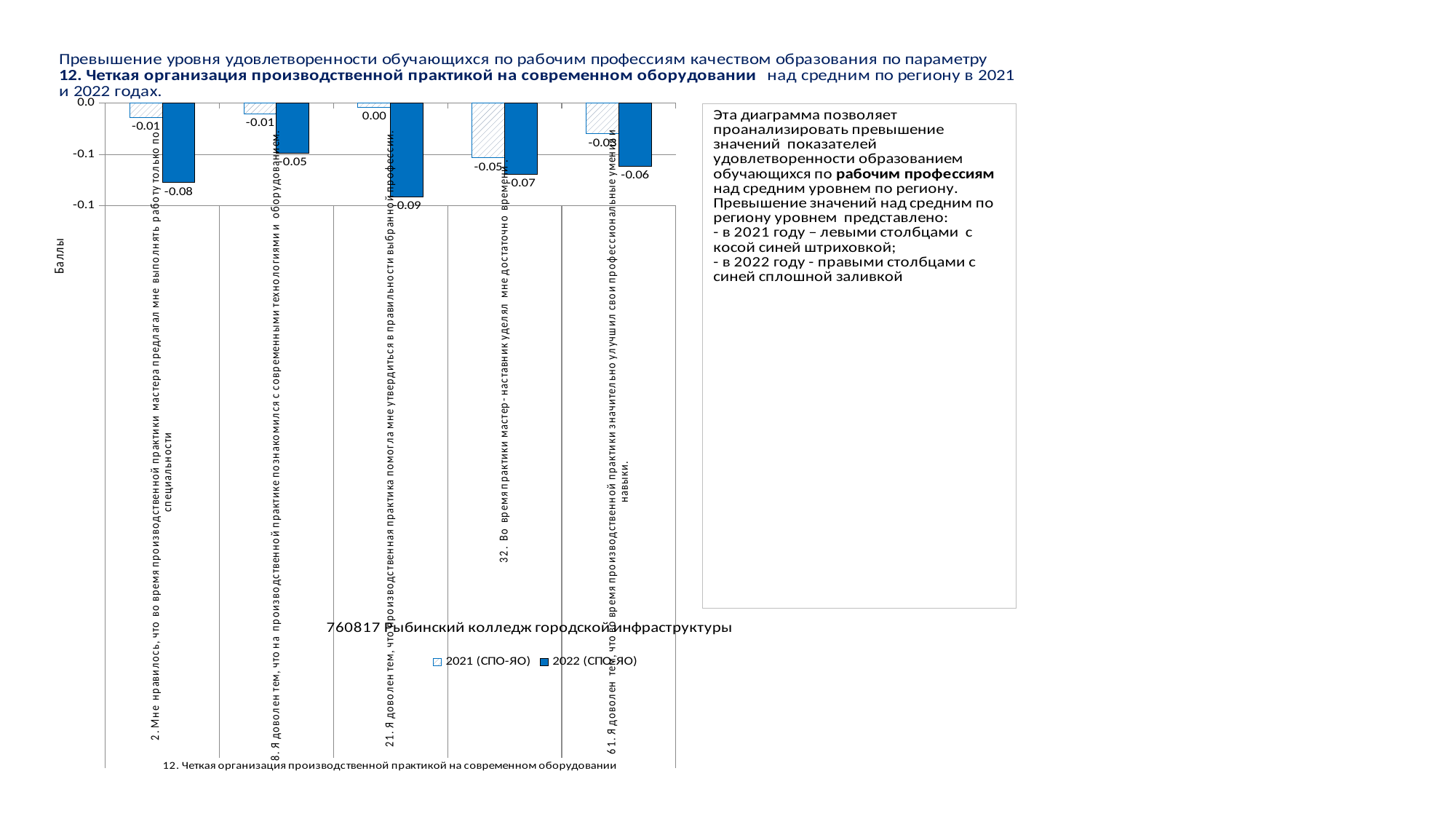
For the 2022 (СПО-ЯО) series, which is higher: the value for statement 2 or the value for statement 8? Statement 8 What kind of chart is shown on the slide? bar chart What are the two legend entries of the chart? 2021 (СПО-ЯО) and 2022 (СПО-ЯО) Which statement has the highest 2022 (СПО-ЯО) value? Statement 8 What is the 2022 (СПО-ЯО) value for statement 2 (Мне нравилось, что во время производственной практики мастера предлагал мне выполнять работу только по специальности)? -0.08 How many series does the chart legend list? 2 What is the 2021 (СПО-ЯО) value for statement 21? 0.00 How many categories (statements) are plotted on the chart? 5 Which statement has the lowest 2022 (СПО-ЯО) value? Statement 21 What is the difference between the 2021 (СПО-ЯО) and 2022 (СПО-ЯО) values for statement 32? 0.02 What is the 2021 (СПО-ЯО) value for statement 32 (Во время практики мастер-наставник уделял мне достаточно времени)? -0.05 What is the 2022 (СПО-ЯО) value for statement 21 (Я доволен тем, что производственная практика помогла мне утвердиться в правильности выбранной профессии)? -0.09